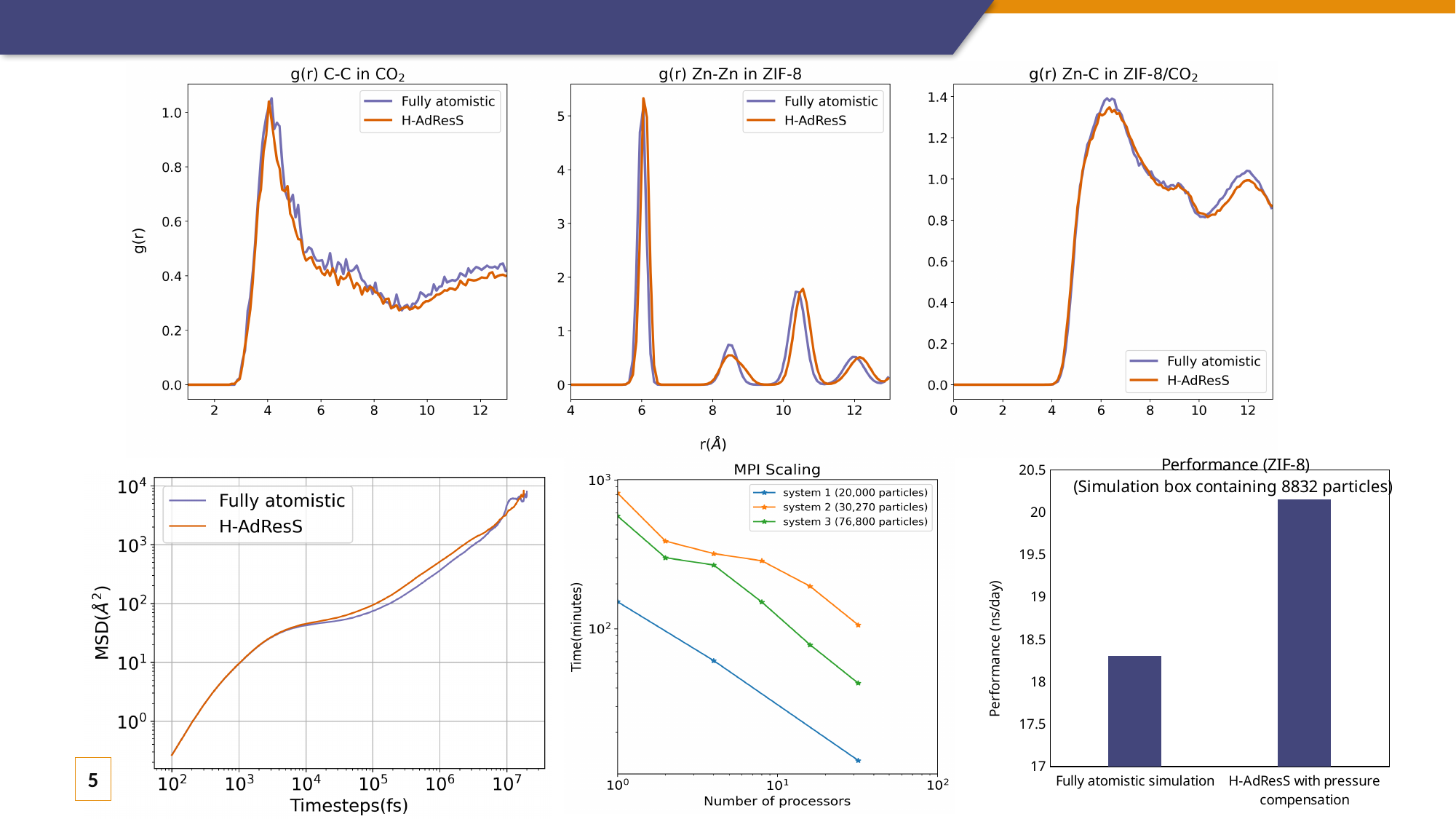
In the 'MPI Scaling' chart, do the times rise or fall as the number of processors increases? fall How many series does the legend of the MSD chart at the bottom left list? 2 In the 'MPI Scaling' chart, which system has the highest time at 1 processor? system 2 (30,270 particles) How many series does the legend of the 'MPI Scaling' chart list? 3 In the 'Performance (ZIF-8)' chart, is the value for 'Fully atomistic simulation' greater or less than 18.5? less What kind of chart is the 'Performance (ZIF-8)' chart at the bottom right of the slide? bar chart In the 'Performance (ZIF-8)' chart, is the value for 'H-AdResS with pressure compensation' greater or less than 20? greater In the 'Performance (ZIF-8)' chart, which is larger: the bar for 'Fully atomistic simulation' or the bar for 'H-AdResS with pressure compensation'? H-AdResS with pressure compensation According to the legend of the 'MPI Scaling' chart, how many particles does system 3 have? 76,800 In the 'Performance (ZIF-8)' chart, which category has the higher performance? H-AdResS with pressure compensation How many categories are shown on the x axis of the 'Performance (ZIF-8)' chart? 2 What is the y-axis label of the 'Performance (ZIF-8)' chart? Performance (ns/day)